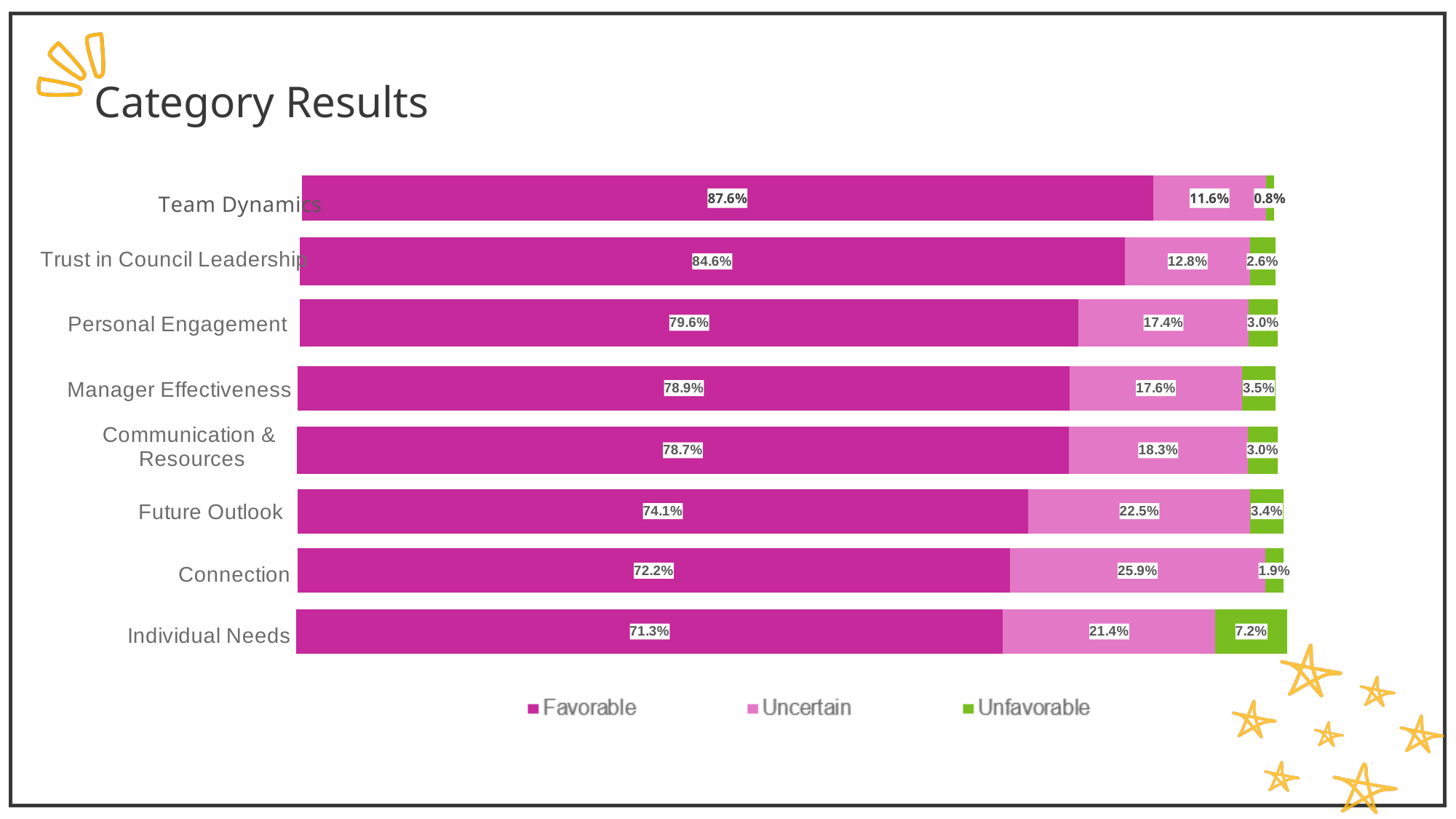
What is the Unfavorable value for Individual Needs? 7.2% Which has a larger Unfavorable value, Manager Effectiveness or Connection? Manager Effectiveness What is the difference between the Favorable values for Team Dynamics and Individual Needs? 16.3 percentage points What type of chart is shown on the slide? Stacked bar chart How many series does the legend list? 3 Which category has the highest Favorable value? Team Dynamics What is the total of the Team Dynamics stacked bar? 100.0% Which category has the lowest Favorable value? Individual Needs What is the Uncertain value for Future Outlook? 22.5% How many categories are shown in the chart? 8 What is the Favorable value for Trust in Council Leadership? 84.6% Which category has the highest Uncertain value? Connection